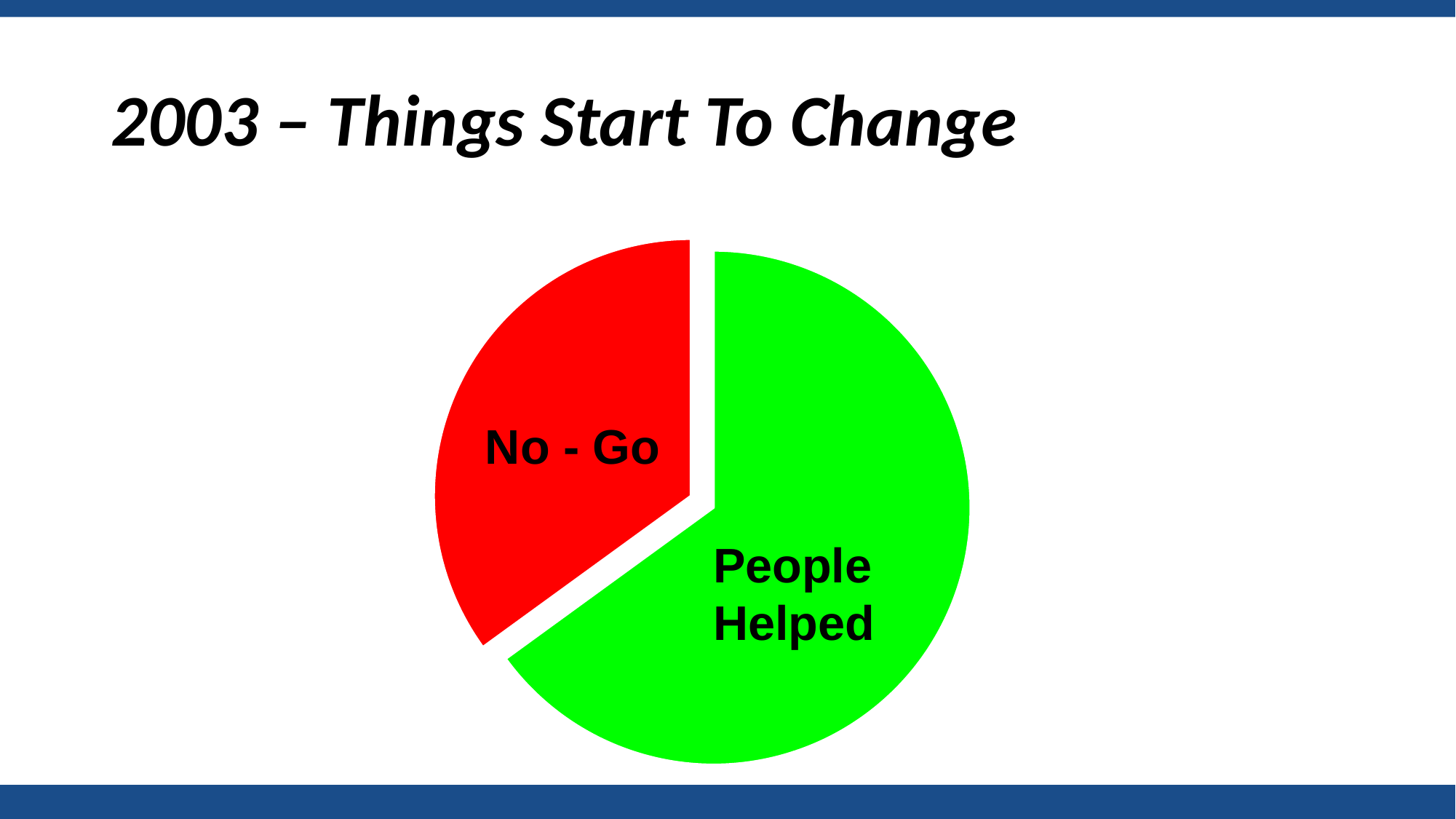
Which slice is larger, No - Go or People Helped? People Helped How many slices does the pie chart have? 2 What colour is the People Helped slice? green Does the People Helped slice take up more or less than half of the pie? more Which slice of the pie chart is the largest? People Helped What kind of chart is shown on the slide? pie chart What colour is the No - Go slice? red Which slice of the pie chart is the smallest? No - Go